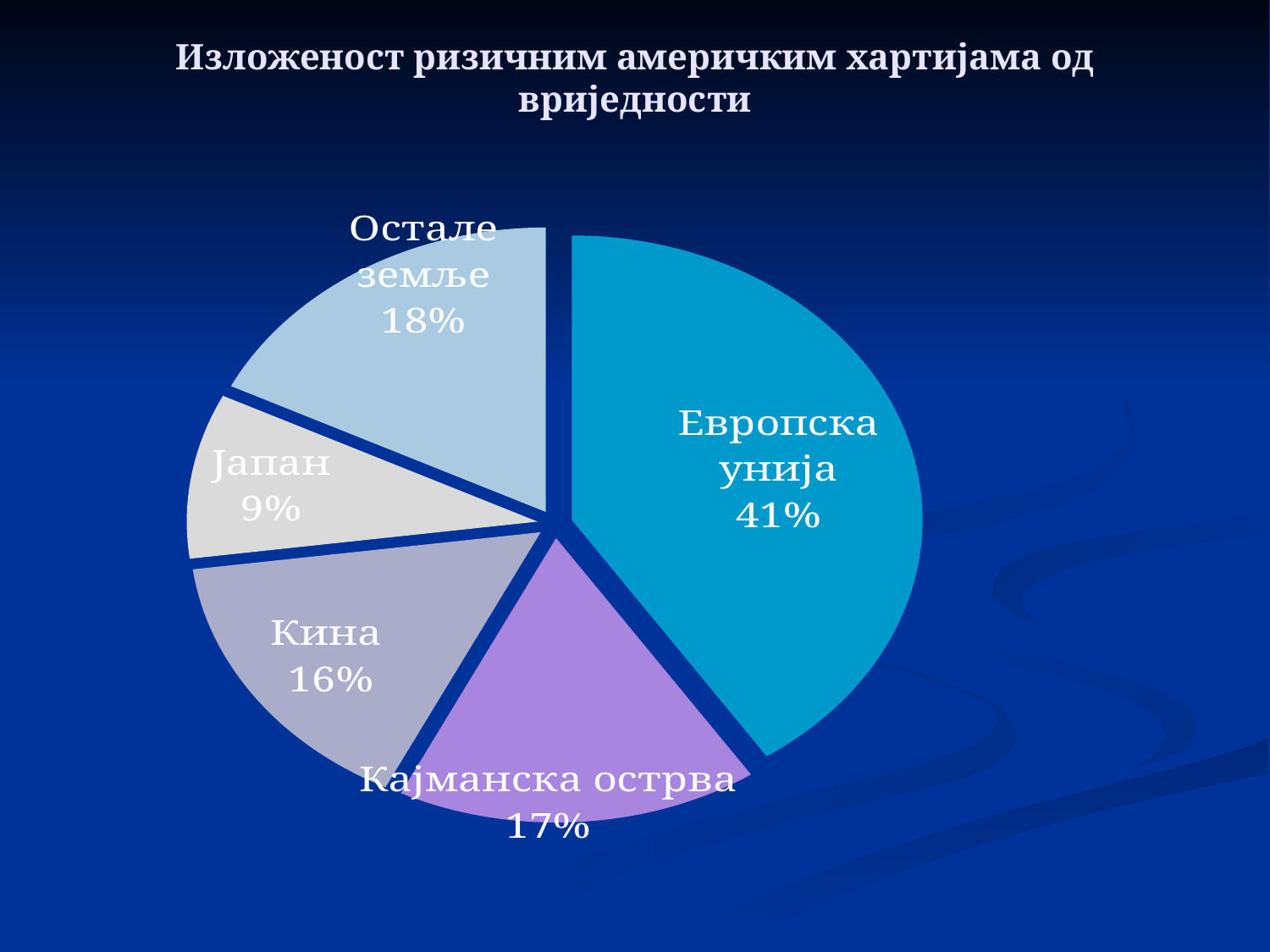
What percentage is shown for Јапан? 9% What kind of chart is shown on the slide? Pie chart What percentage is shown for Кајманска острва? 17% How many slices does the pie chart have? 5 Which slice of the pie is the smallest? Јапан What percentage is shown for Кина? 16% What percentage is shown for Остале земље? 18% What share of the pie does Европска унија hold? 41% Which is larger, the share for Кина or the share for Јапан? Кина What is the title of the chart? Изложеност ризичним америчким хартијама од вриједности What is the difference in percentage points between Европска унија and Остале земље? 23 Which slice of the pie is the largest? Европска унија